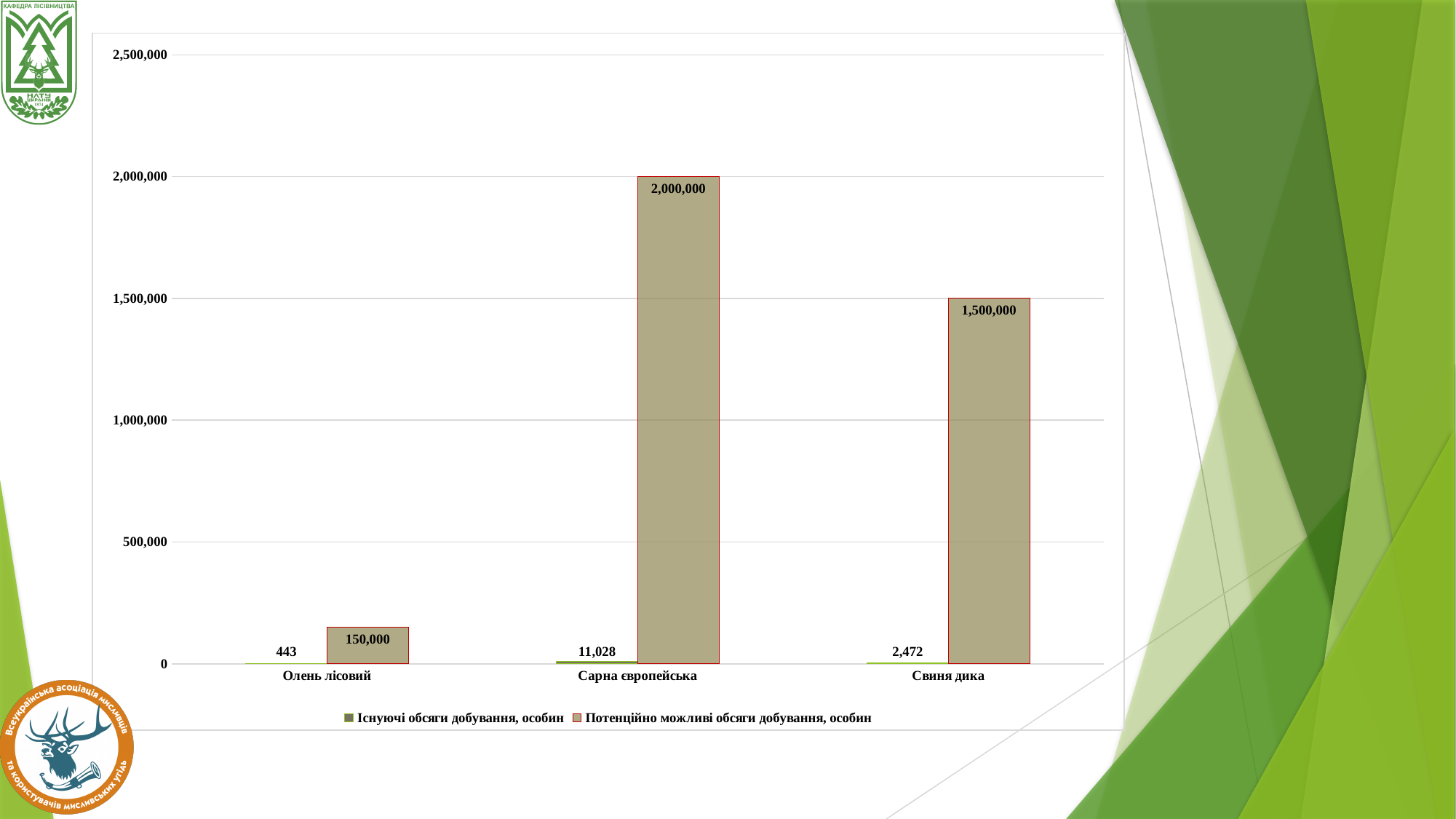
What kind of chart is shown on the slide? bar chart Which is larger: the 'Існуючі обсяги добування, особин' value for Сарна європейська or for Свиня дика? Сарна європейська Which category has the lowest value for 'Існуючі обсяги добування, особин'? Олень лісовий What is the difference between the 'Потенційно можливі обсяги добування, особин' values for Сарна європейська and Свиня дика? 500,000 What is the value of 'Потенційно можливі обсяги добування, особин' for Олень лісовий? 150,000 What is the value of 'Потенційно можливі обсяги добування, особин' for Сарна європейська? 2,000,000 Which category has the highest value for 'Потенційно можливі обсяги добування, особин'? Сарна європейська How many categories are shown on the x axis? 3 Is the 'Потенційно можливі обсяги добування, особин' value for Свиня дика greater or less than 1,000,000? greater What is the value of 'Існуючі обсяги добування, особин' for Олень лісовий? 443 How many series does the legend list? 2 What is the value of 'Існуючі обсяги добування, особин' for Свиня дика? 2,472